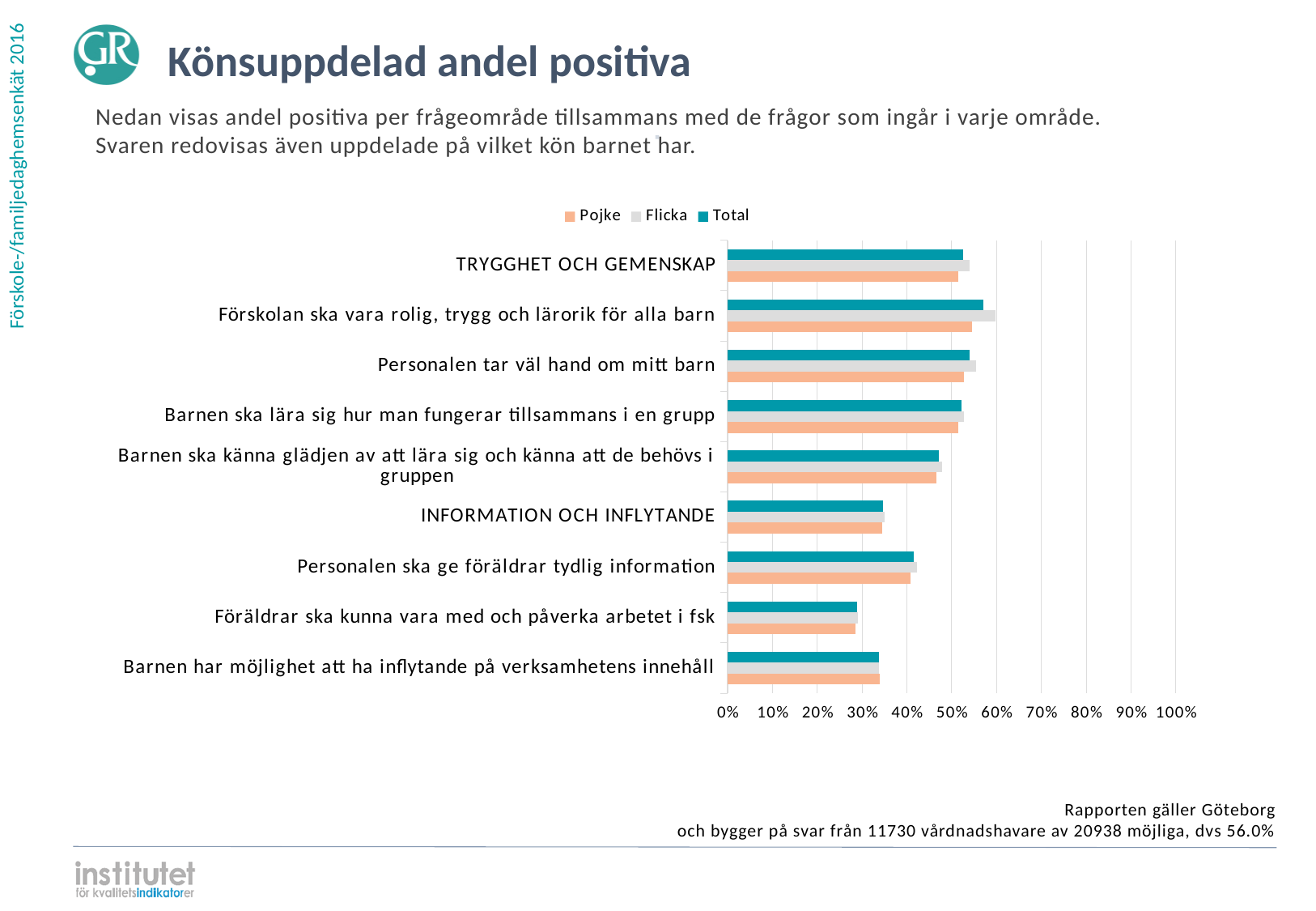
What is the title of the slide containing the chart? Könsuppdelad andel positiva Is the Total value for 'Barnen ska känna glädjen av att lära sig och känna att de behövs i gruppen' greater or less than 50%? less Which series is shown in orange in the legend? Pojke How many series does the legend list? 3 Which has a higher Total value: TRYGGHET OCH GEMENSKAP or INFORMATION OCH INFLYTANDE? TRYGGHET OCH GEMENSKAP Is the Total value for TRYGGHET OCH GEMENSKAP greater or less than 50%? greater Which category has the lowest share of positive responses? Föräldrar ska kunna vara med och påverka arbetet i fsk Which category has the highest share of positive responses? Förskolan ska vara rolig, trygg och lärorik för alla barn Is the Total value for INFORMATION OCH INFLYTANDE greater or less than 40%? less What kind of chart is shown on the slide? bar chart How many categories are plotted on the y axis of the chart? 9